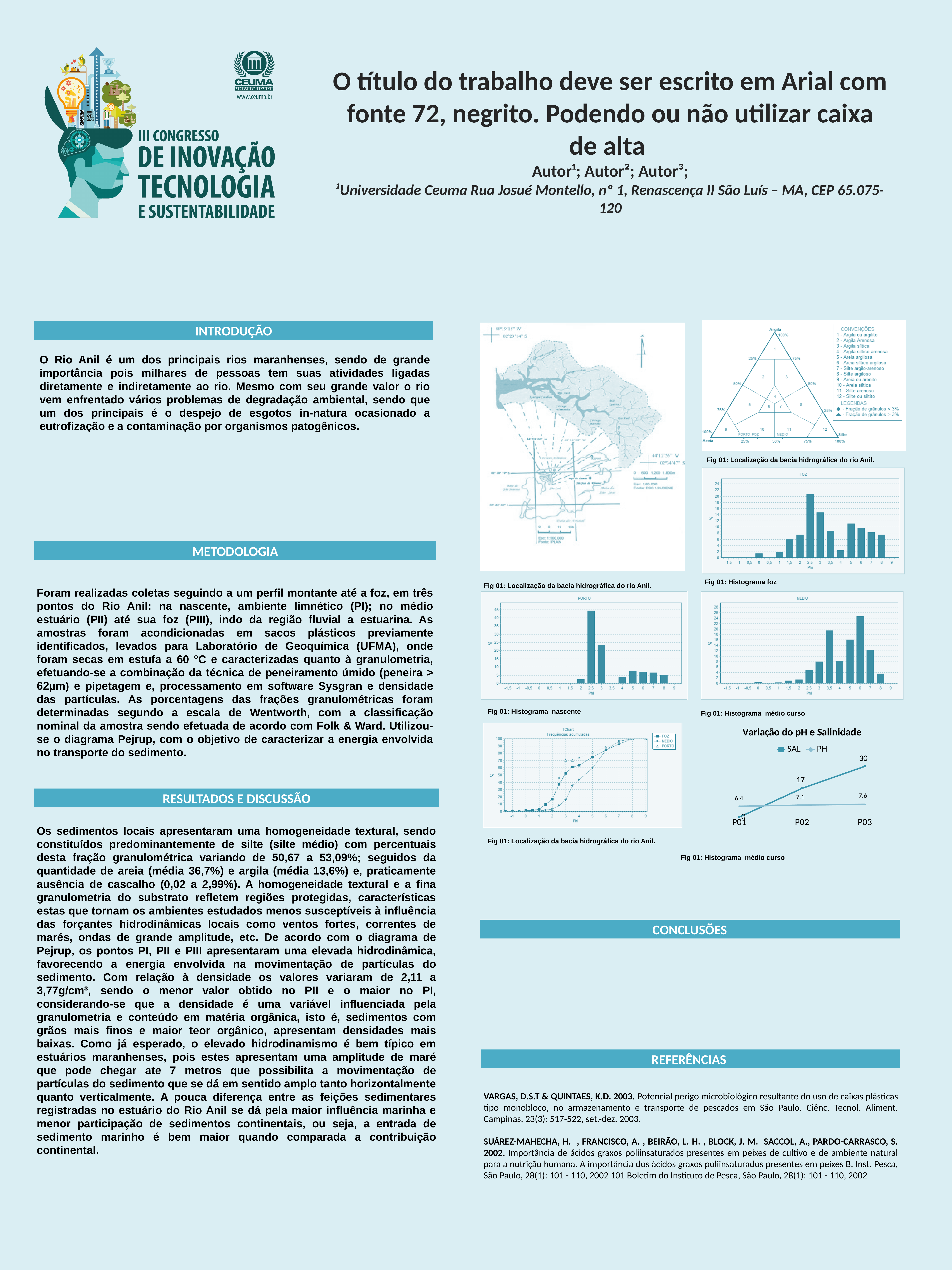
In the 'Variação do pH e Salinidade' chart, what is the SAL value at P03? 30 In the 'Variação do pH e Salinidade' chart, what is the difference between the SAL values at P03 and P02? 13 In the 'Variação do pH e Salinidade' chart, how many points are on the x axis? 3 In the 'Variação do pH e Salinidade' chart, at which point is PH lowest? P01 In the 'Variação do pH e Salinidade' chart, what is the SAL value at P02? 17 In the 'Variação do pH e Salinidade' chart, at which point is SAL highest? P03 In the 'Variação do pH e Salinidade' chart, what kind of chart is it? line chart In the PORTO histogram (Fig 01: Histograma nascente), is the value at Phi 2.5 greater or less than 40? greater In the 'Variação do pH e Salinidade' chart, how many series does the legend list? 2 In the 'Variação do pH e Salinidade' chart, what is the PH value at P03? 7.6 In the 'Variação do pH e Salinidade' chart, does SAL rise or fall from P01 to P03? rise In the 'Variação do pH e Salinidade' chart, what is the PH value at P01? 6.4